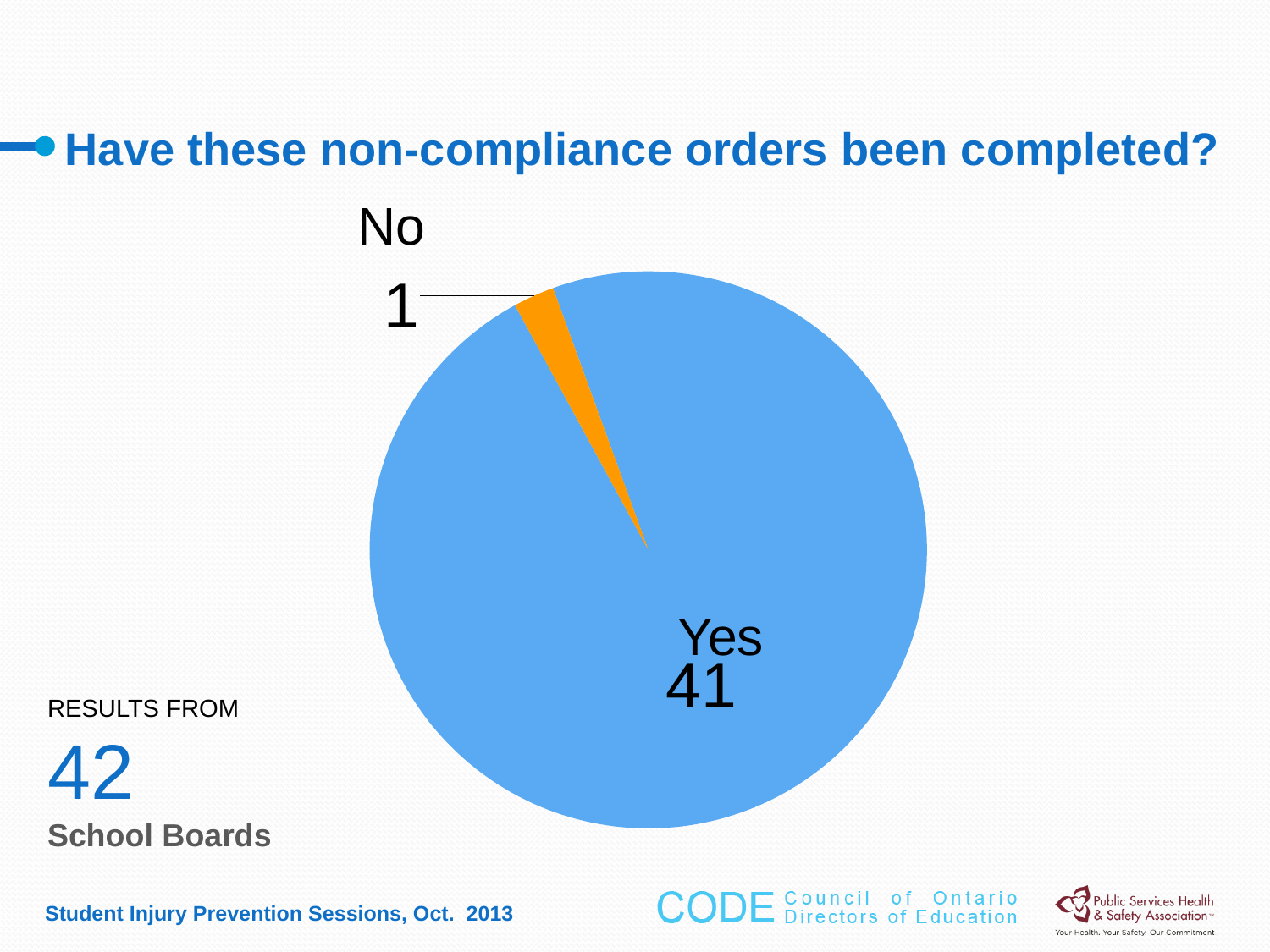
How many school boards do the results come from, according to the slide? 42 What is the difference between the number of "Yes" and "No" responses? 40 What kind of chart is shown on the slide? pie chart What colour is the "No" slice? orange How many slices does the pie chart have? 2 How many school boards answered "Yes" to whether the non-compliance orders have been completed? 41 What is the total of the two slices in the pie chart? 42 Which response has the largest slice of the pie? Yes How many school boards answered "No"? 1 What question does the chart title ask? Have these non-compliance orders been completed? Which response has the smallest slice of the pie? No Which is larger, the "Yes" count or the "No" count? Yes